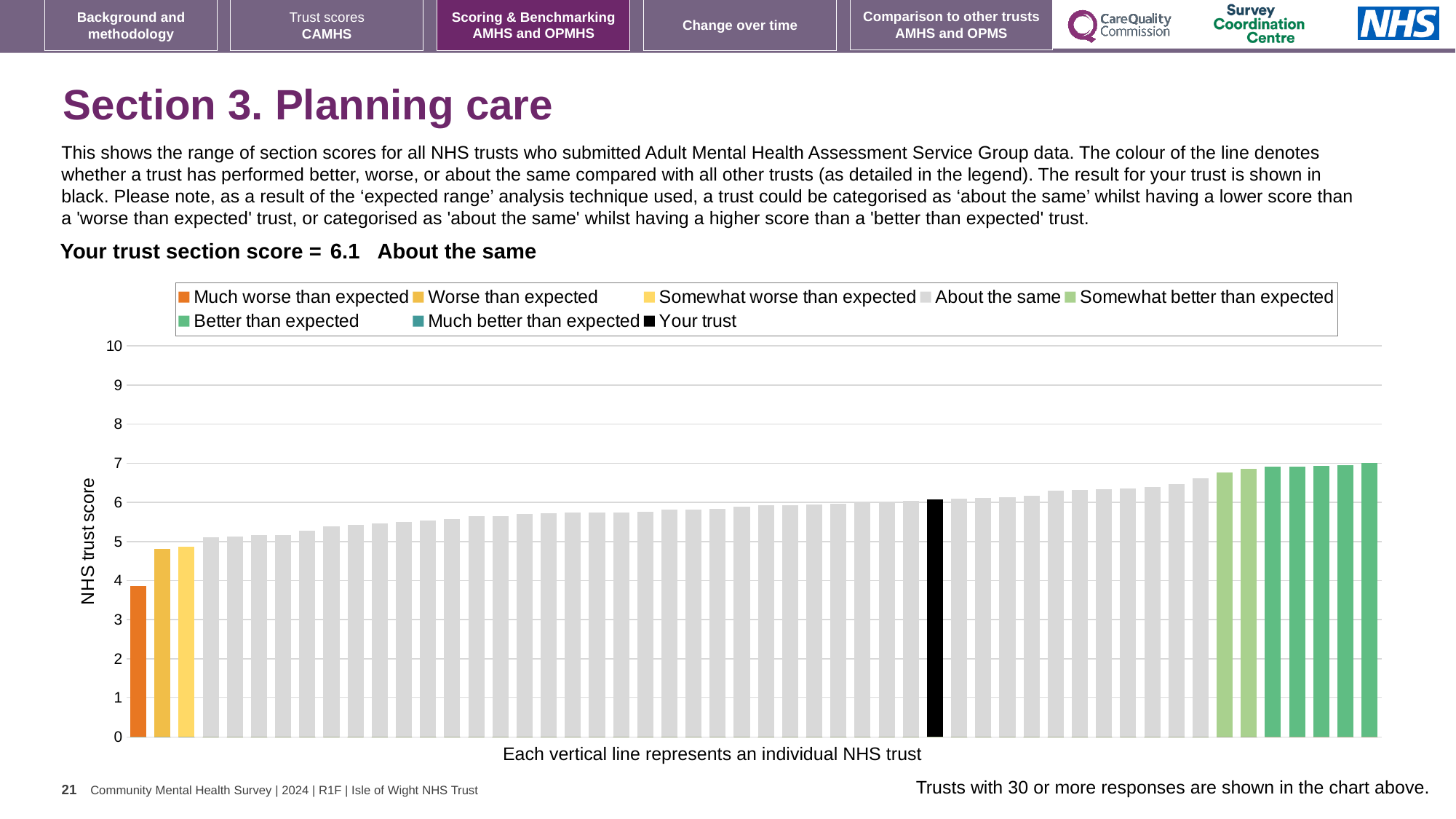
Is the value of the rightmost bar greater or less than 6? greater How many entries does the chart legend list? 8 Is the value of the black 'Your trust' bar greater or less than 7? less Which category is your trust's section score placed in? About the same What is your trust's section score for Planning care? 6.1 How many bars are coloured orange (Much worse than expected)? 1 How many bars are coloured dark green (Better than expected)? 5 Which is larger, the black 'Your trust' bar or the orange 'Much worse than expected' bar? the black 'Your trust' bar What is the label on the vertical axis of the chart? NHS trust score What kind of chart is shown on the slide? bar chart Do the bar values rise or fall from left to right along the x axis? rise Is the value of the leftmost (orange) bar greater or less than 5? less